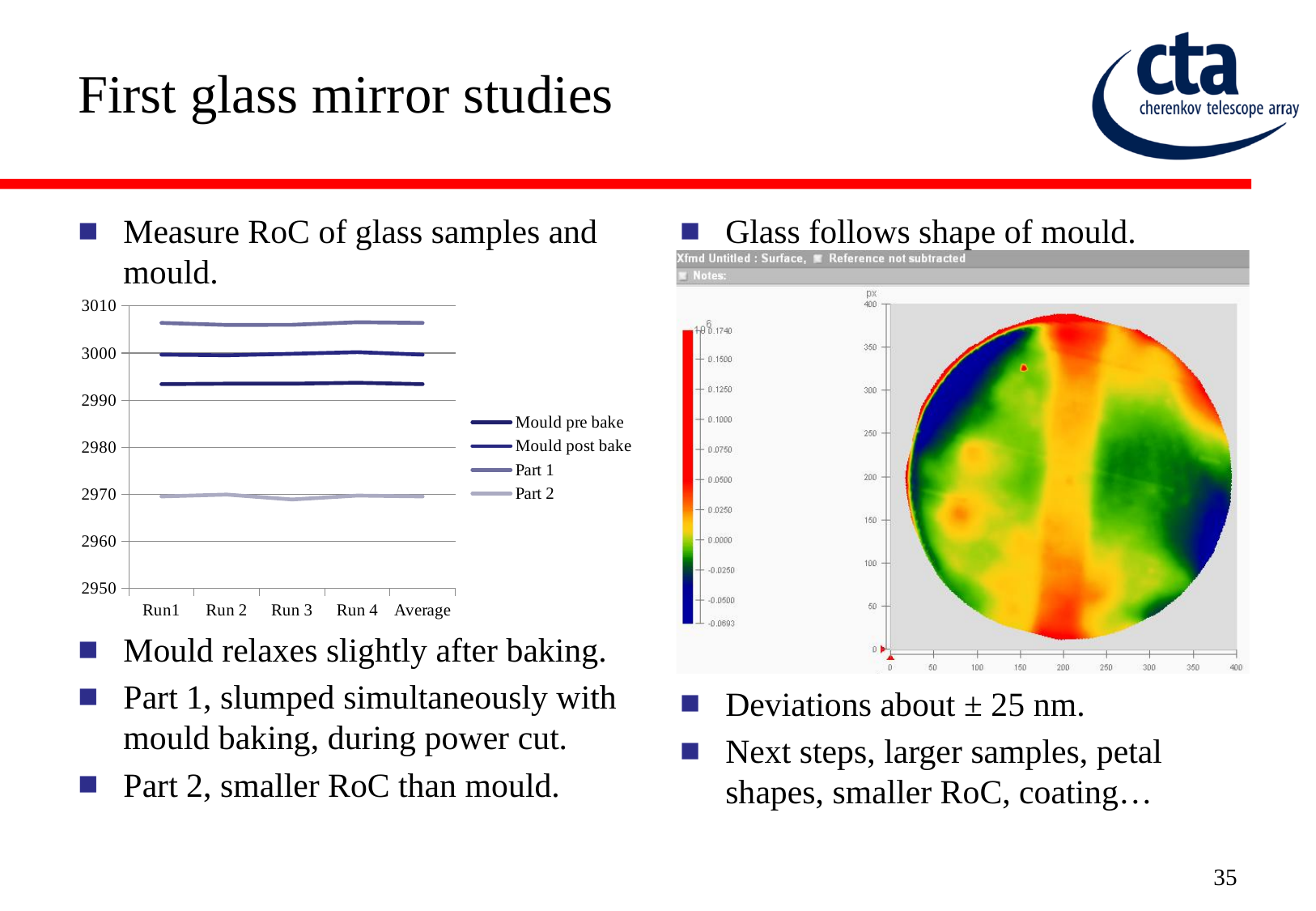
What kind of chart is shown on the left of the slide? line chart How many series does the legend of the line chart list? 4 In the line chart, which series has the lowest values? Part 2 In the line chart, does the Part 2 line rise strongly, fall strongly, or stay roughly flat across the runs? roughly flat In the line chart, which series has the highest values? Part 1 In the line chart, is the value for Part 1 at Average greater or less than 3000? greater In the line chart, is the value for Mould pre bake at Run 2 greater or less than 2990? greater How many categories are on the x axis of the line chart? 5 In the line chart, is the value for Part 2 at Run1 greater or less than 2980? less In the line chart, which is larger at Run 3: Part 1 or Part 2? Part 1 What is the last category on the x axis of the line chart? Average What are the series names listed in the legend of the line chart? Mould pre bake, Mould post bake, Part 1, Part 2